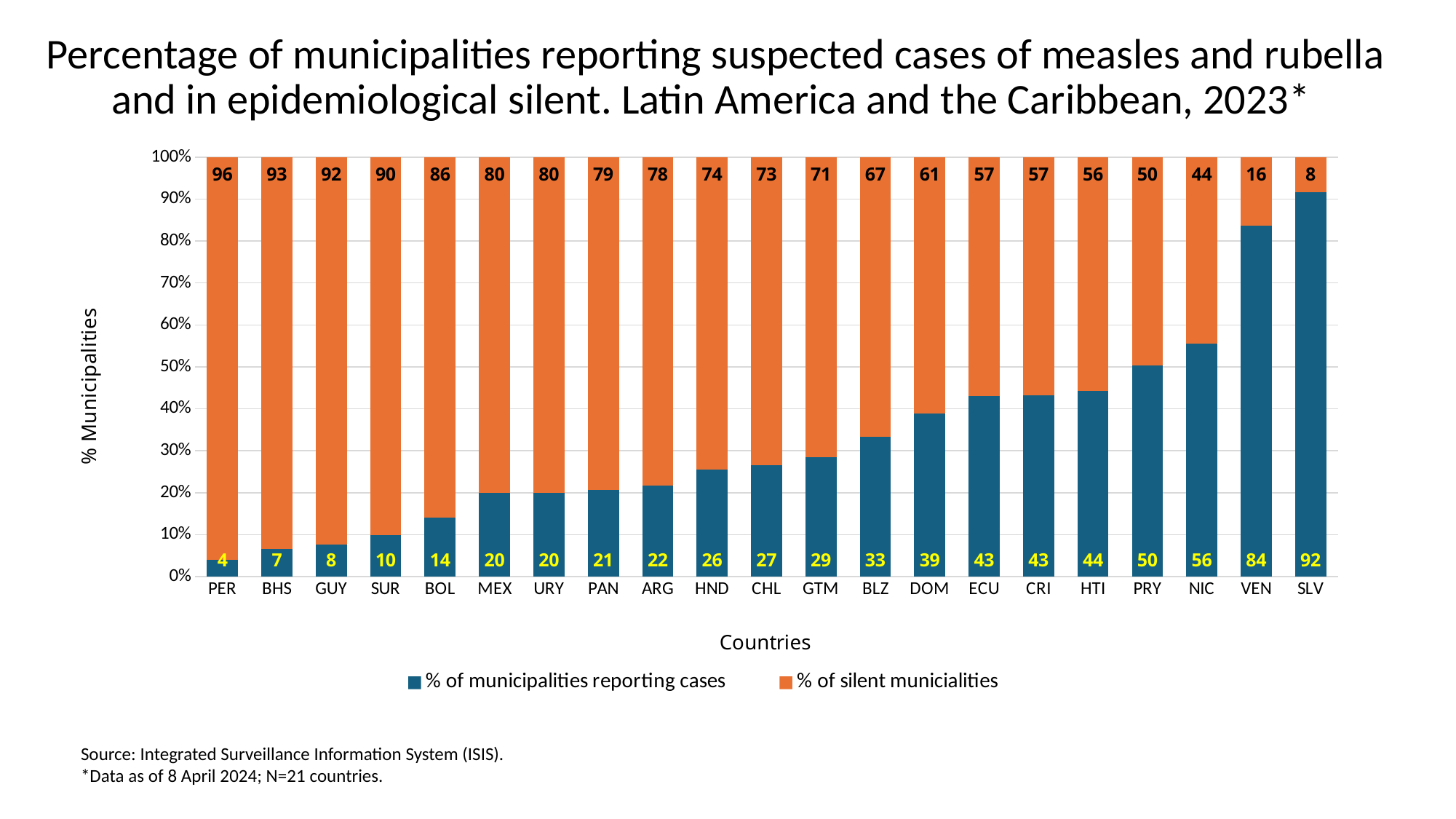
What colour represents % of silent municipalities in the legend? Orange What is the value for % of silent municipalities for PER? 96 What kind of chart is shown on the slide? Stacked bar chart What is the value for % of municipalities reporting cases for MEX? 20 How many series does the legend list? 2 Which is larger, the % of municipalities reporting cases for DOM or for BLZ? DOM Which country has the highest % of municipalities reporting cases? SLV How many countries are shown on the x axis? 21 Which country has the lowest % of municipalities reporting cases? PER Do the values for % of municipalities reporting cases rise or fall from left to right along the x axis? Rise What is the value for % of municipalities reporting cases for VEN? 84 What is the difference between the % of silent municipalities for BHS and for NIC? 49